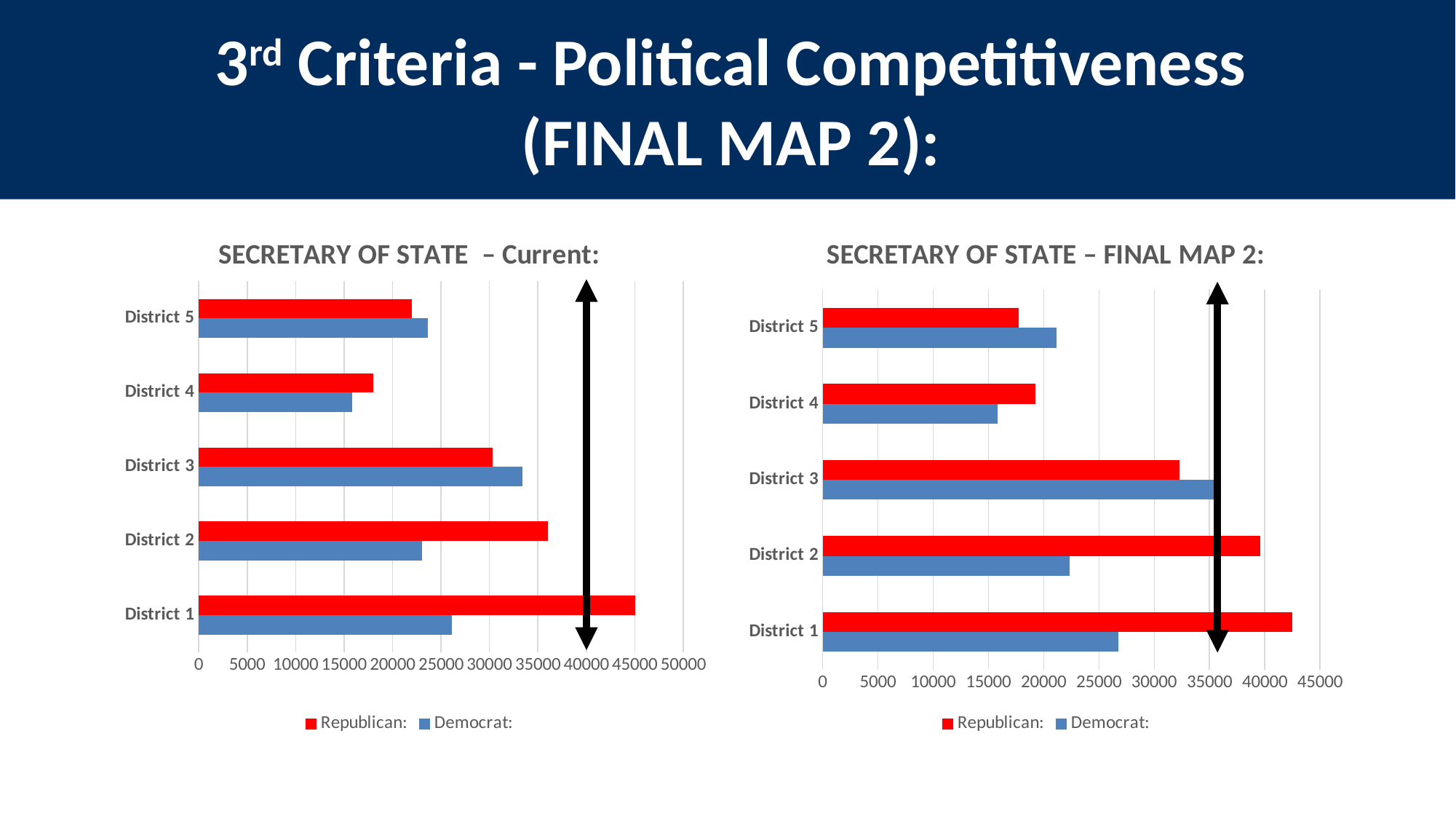
In the 'SECRETARY OF STATE – Current:' chart, how many series does the legend list? 2 In the 'SECRETARY OF STATE – Current:' chart, which is larger for District 3, the Republican or the Democrat value? Democrat In the 'SECRETARY OF STATE – Current:' chart, which district has the lowest Republican value? District 4 In the 'SECRETARY OF STATE – Current:' chart, how many districts are shown? 5 What kind of chart is the 'SECRETARY OF STATE – Current:' chart? bar chart In the 'SECRETARY OF STATE – FINAL MAP 2:' chart, which district has the highest Democrat value? District 3 In the 'SECRETARY OF STATE – Current:' chart, is the Republican value for District 1 greater or less than 40000? greater In the 'SECRETARY OF STATE – Current:' chart, which district has the highest Republican value? District 1 In the 'SECRETARY OF STATE – FINAL MAP 2:' chart, is the Republican value for District 2 greater or less than 35000? greater In the 'SECRETARY OF STATE – Current:' chart, is the Democrat value for District 4 greater or less than 20000? less In the 'SECRETARY OF STATE – FINAL MAP 2:' chart, which colour represents the Republican series? red